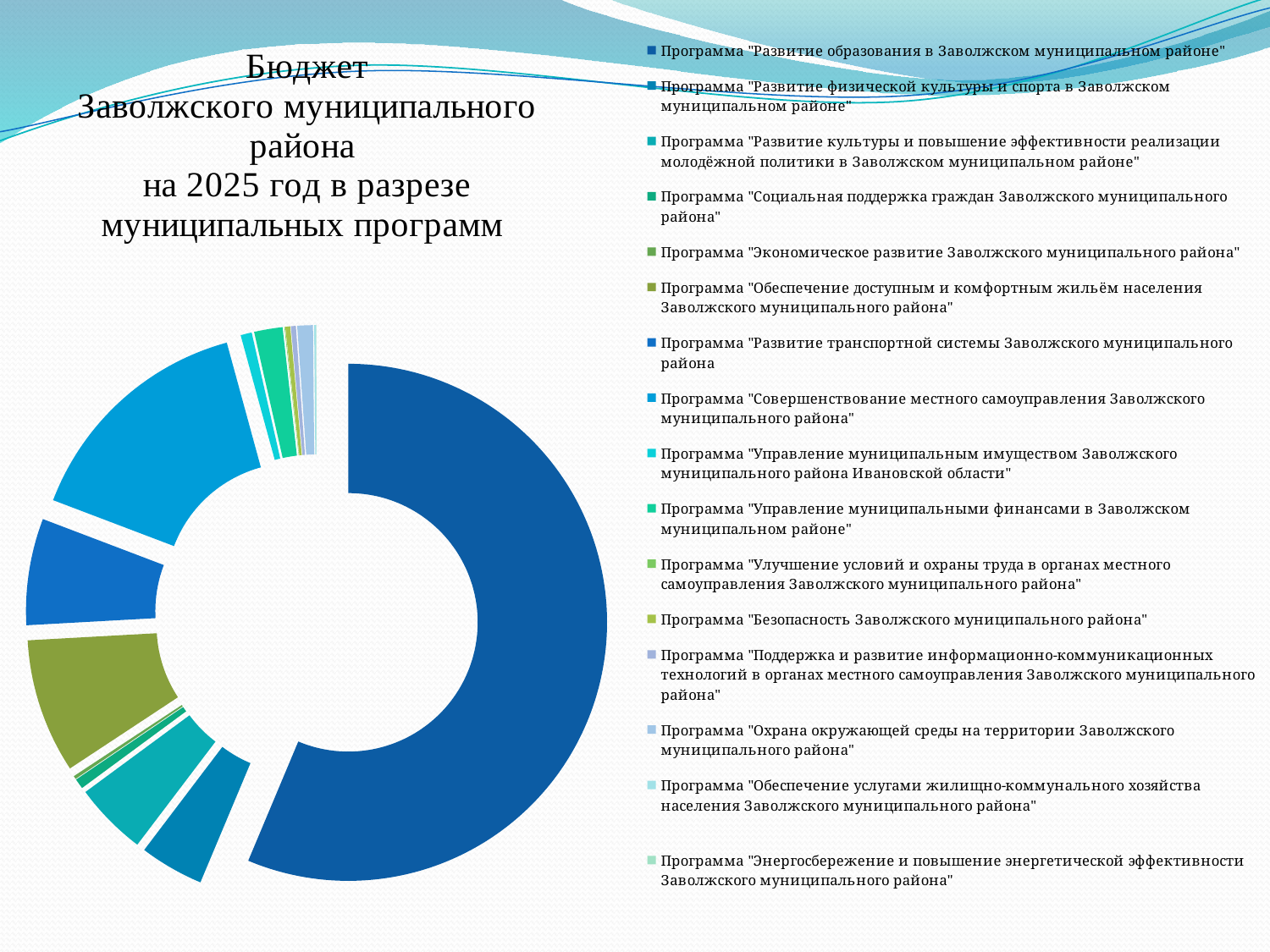
Which program has the largest slice in the chart? Программа "Развитие образования в Заволжском муниципальном районе" Which program is listed first in the chart legend? Программа "Развитие образования в Заволжском муниципальном районе" How many programs are listed in the chart legend? 16 What is the title of the slide with the chart? Бюджет Заволжского муниципального района на 2025 год в разрезе муниципальных программ Which year does the budget chart refer to? 2025 What kind of chart is shown on the slide? Doughnut (pie) chart Which is larger: the slice for "Развитие образования в Заволжском муниципальном районе" or the slice for "Энергосбережение и повышение энергетической эффективности Заволжского муниципального района"? Развитие образования в Заволжском муниципальном районе